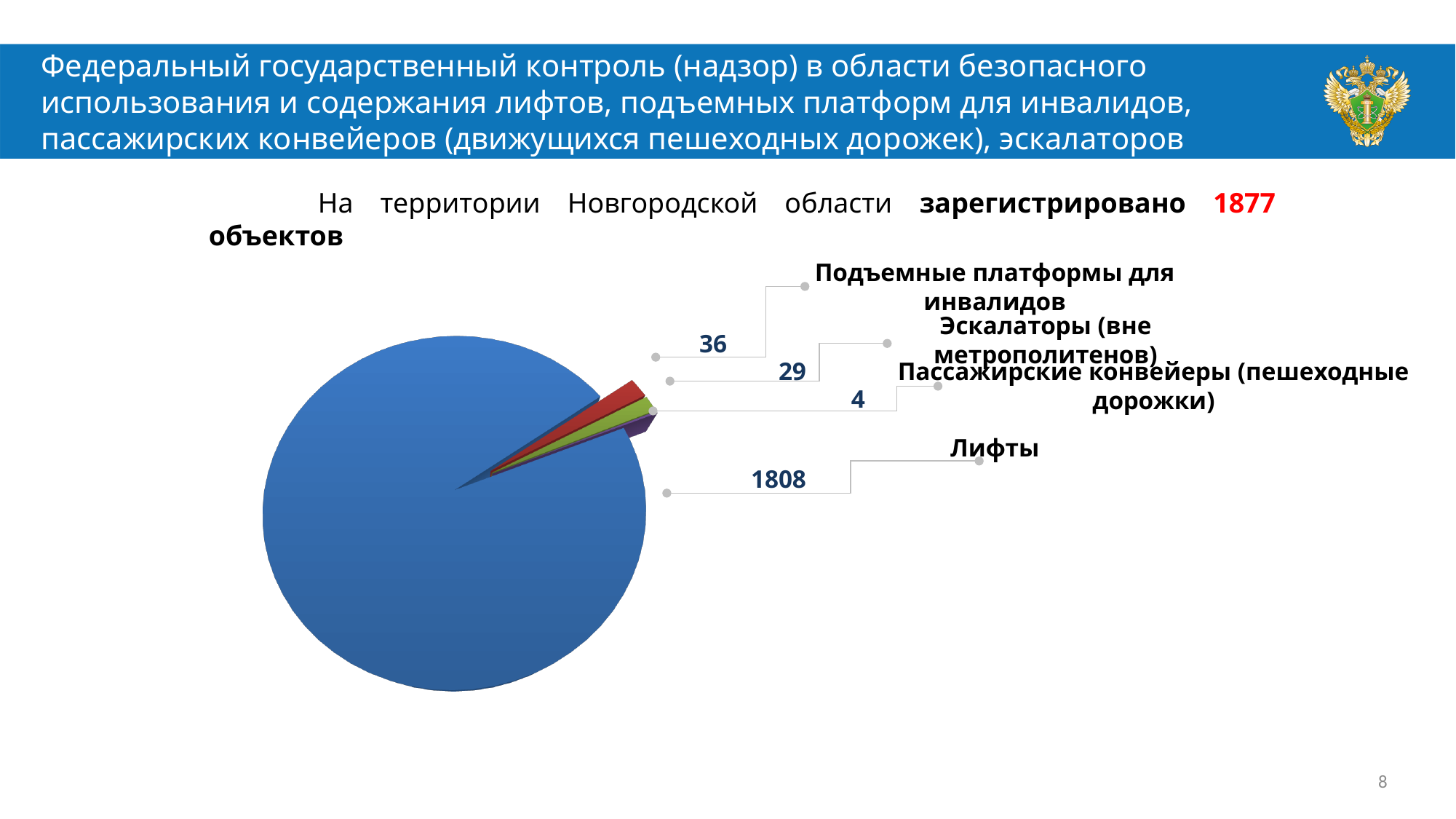
Which is larger: the value for Эскалаторы (вне метрополитенов) or for Пассажирские конвейеры (пешеходные дорожки)? Эскалаторы (вне метрополитенов) What is the value for Эскалаторы (вне метрополитенов)? 29 What is the total number of registered objects shown on the slide? 1877 What is the value for Пассажирские конвейеры (пешеходные дорожки)? 4 What type of chart is shown on the slide? pie chart What is the value for Лифты in the pie chart? 1808 Which category has the smallest slice in the pie chart? Пассажирские конвейеры (пешеходные дорожки) What is the difference between the values for Подъемные платформы для инвалидов and Эскалаторы (вне метрополитенов)? 7 How many slices does the pie chart have? 4 What is the difference between the values for Лифты and Подъемные платформы для инвалидов? 1772 What is the value for Подъемные платформы для инвалидов? 36 Which category has the largest slice in the pie chart? Лифты